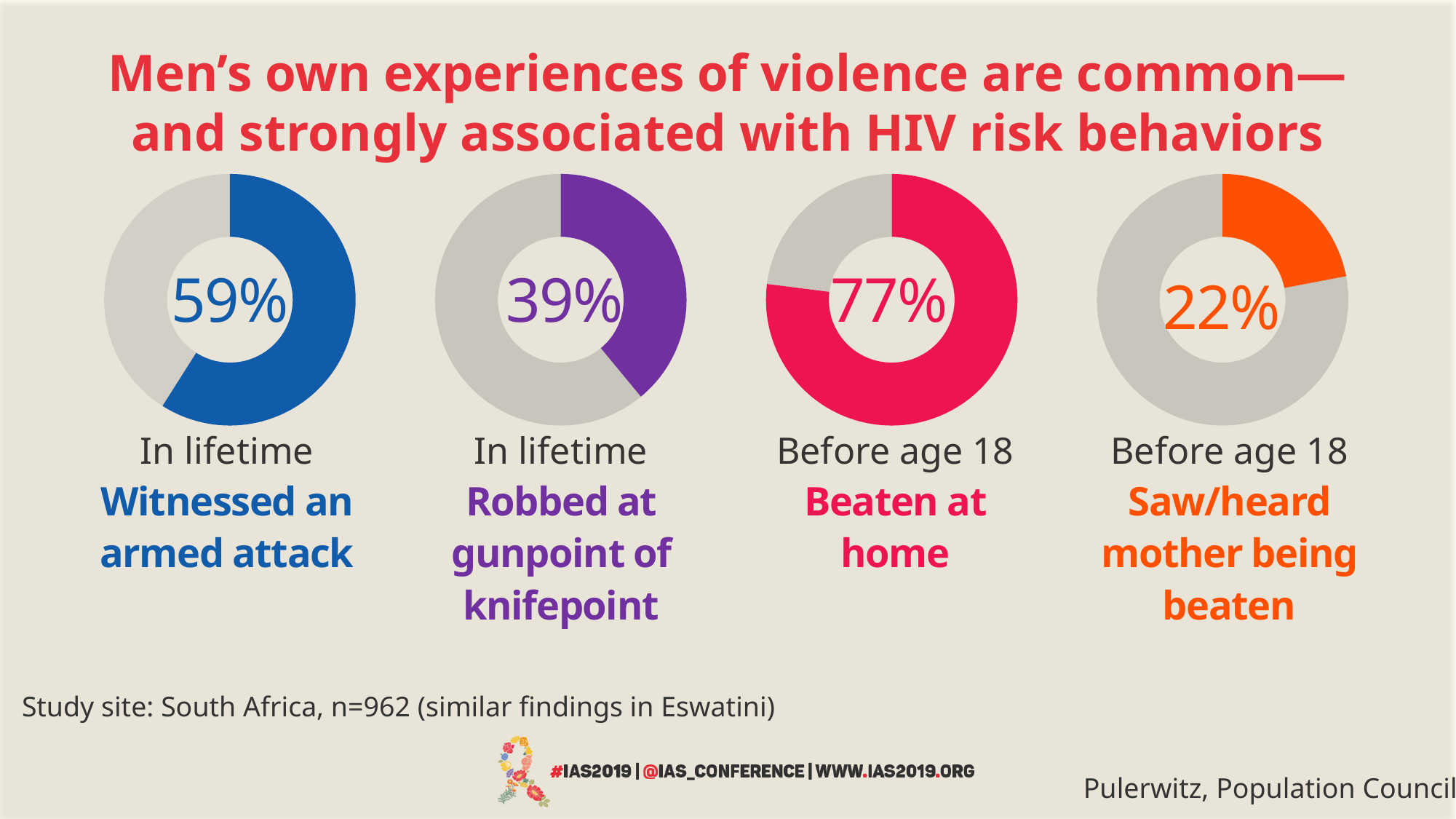
Which experience of violence has the highest percentage on the slide? Beaten at home What kind of chart is used to show each percentage on the slide? Donut (pie) chart Which is larger: the percentage who witnessed an armed attack or the percentage robbed at gunpoint or knifepoint? Witnessed an armed attack What is the difference in percentage points between men beaten at home before age 18 and men who saw/heard their mother being beaten? 55 What percentage of men were beaten at home before age 18? 77% What is the difference in percentage points between witnessing an armed attack and being robbed at gunpoint or knifepoint? 20 What colour is the donut chart for 'Beaten at home'? Pink/red Which experience of violence has the lowest percentage on the slide? Saw/heard mother being beaten What percentage of men were robbed at gunpoint or knifepoint in their lifetime? 39% How many donut charts are shown on the slide? 4 What percentage of men saw or heard their mother being beaten before age 18? 22% What percentage of men witnessed an armed attack in their lifetime? 59%